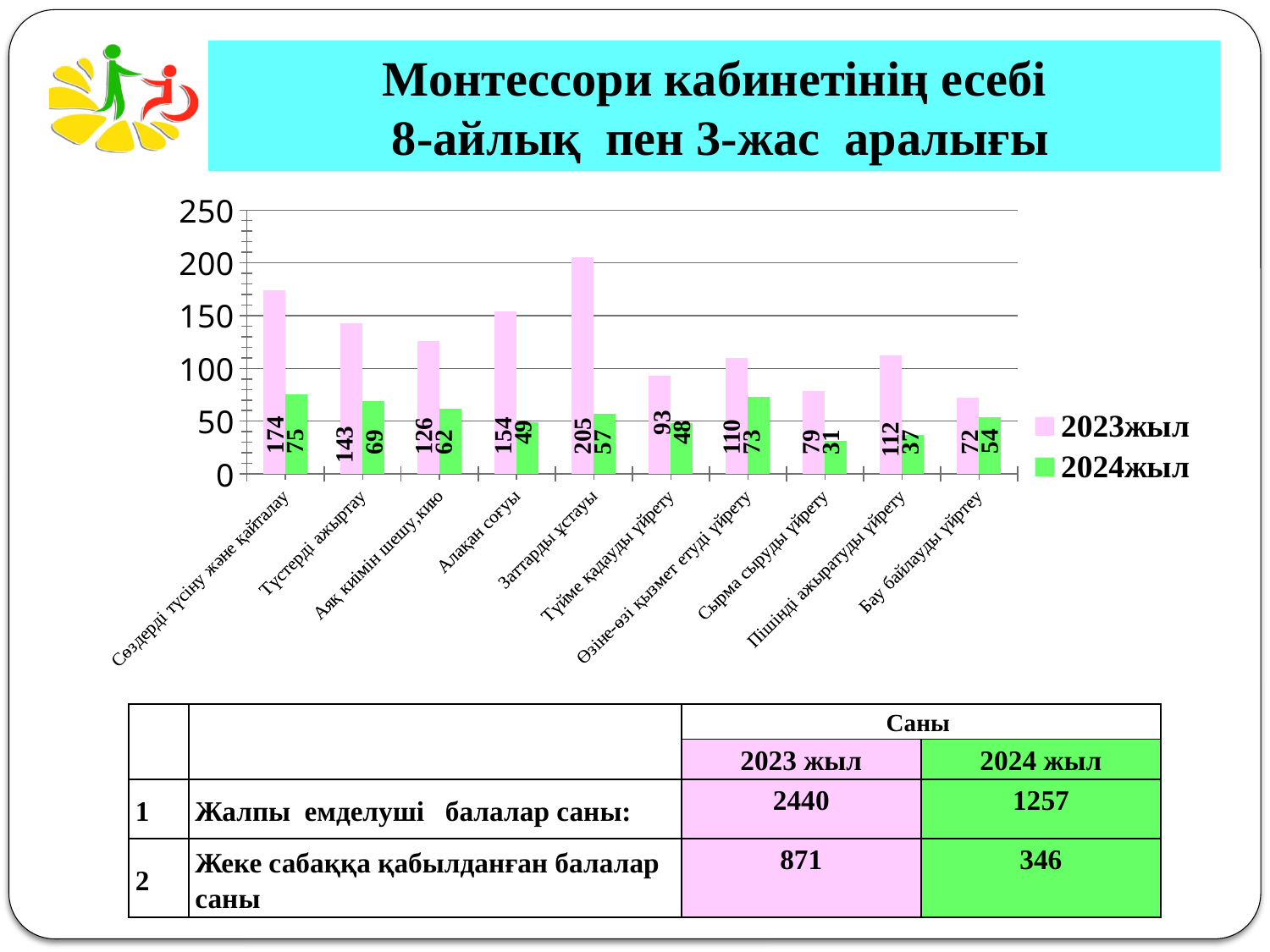
What is the 2024жыл value for Түстерді ажырату? 69 What is the 2023жыл value for Сырма сыруды үйрету? 79 What is the 2023жыл value for Заттарды ұстауы? 205 Which colour represents the 2024жыл series in the chart? green How many categories are shown on the x axis of the chart? 10 What is the difference between the 2023жыл and 2024жыл values for Сөздерді түсіну және қайталау? 99 What kind of chart is shown on the slide? bar chart Is the 2023жыл value for Алақан соғуы greater or less than 150? greater How many series does the chart legend list? 2 Which is larger: the 2024жыл value for Өзіне-өзі қызмет етуді үйрету or the 2024жыл value for Бау байлауды үйрету? Өзіне-өзі қызмет етуді үйрету Which category has the lowest 2024жыл value? Сырма сыруды үйрету Which category has the highest 2023жыл value? Заттарды ұстауы